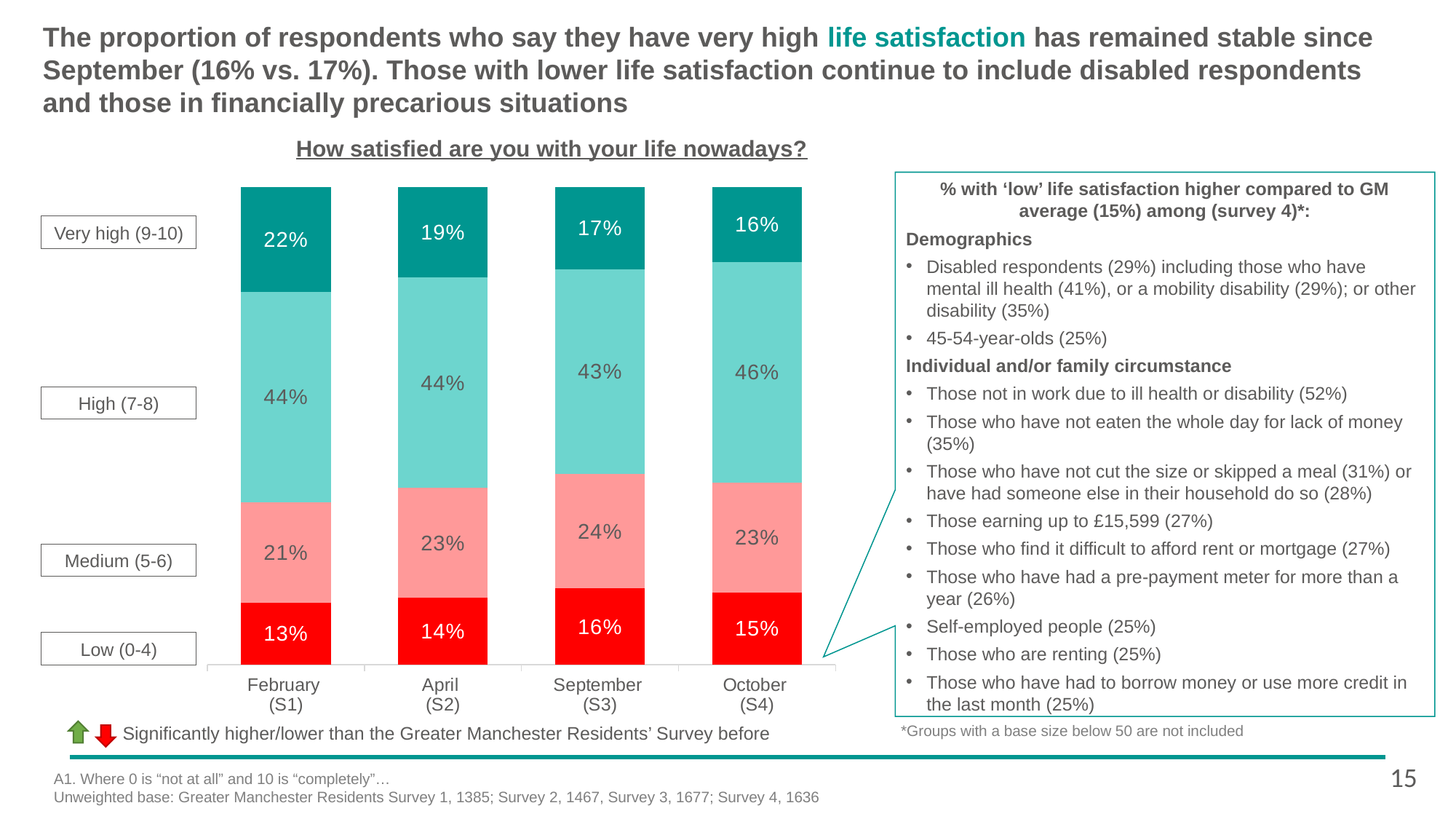
What percentage of respondents reported medium (5-6) life satisfaction in April (S2)? 23% What percentage of respondents reported low (0-4) life satisfaction in September (S3)? 16% In which survey wave was the share of respondents with very high (9-10) life satisfaction the highest? February (S1) How many survey waves are shown on the x axis of the chart? 4 How many life satisfaction categories are stacked in each bar? 4 What percentage of respondents reported high (7-8) life satisfaction in October (S4)? 46% What percentage of respondents reported very high (9-10) life satisfaction in February (S1)? 22% By how many percentage points did the very high (9-10) share fall between February (S1) and October (S4)? 6 percentage points What type of chart is used to show life satisfaction across the survey waves? Stacked bar chart Does the very high (9-10) share rise or fall from February (S1) to October (S4)? Fall Which is larger: the high (7-8) share in September (S3) or in October (S4)? October (S4) In which survey wave was the share of respondents with low (0-4) life satisfaction the lowest? February (S1)